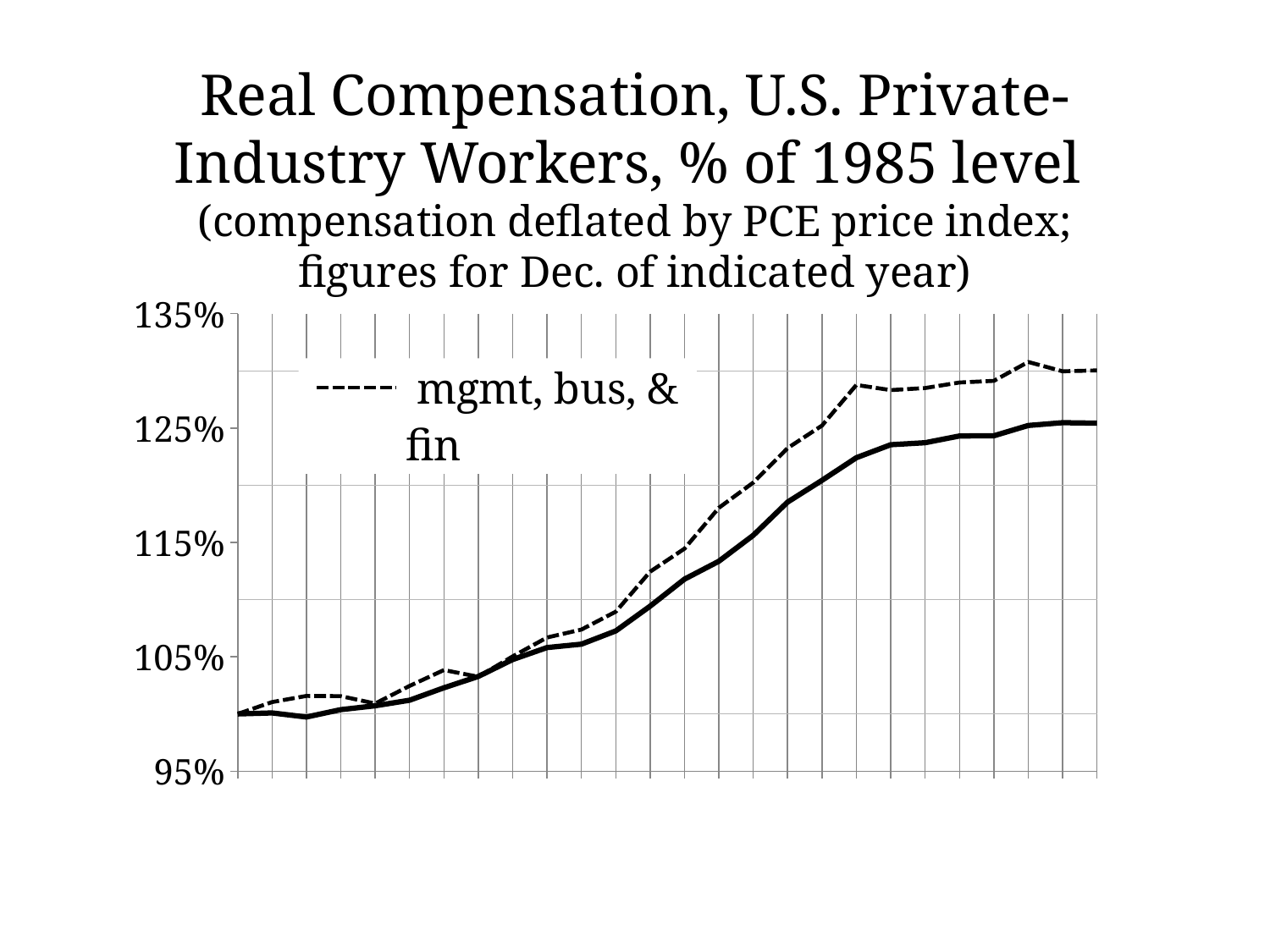
What is the lowest value shown on the vertical axis? 95% What is the title of the chart? Real Compensation, U.S. Private-Industry Workers, % of 1985 level What kind of chart is shown on the slide? line chart Do the values of the solid line generally rise or fall from left to right? rise Do the values of the dashed 'mgmt, bus, & fin' line generally rise or fall from left to right? rise Is the final value of the dashed 'mgmt, bus, & fin' line greater or less than 125%? greater What series name does the legend list for the dashed line? mgmt, bus, & fin Is the starting value of the solid line at the left of the chart greater or less than 105%? less At the right end of the chart, which line is higher: the dashed 'mgmt, bus, & fin' line or the solid line? the dashed 'mgmt, bus, & fin' line Is the highest value reached by the dashed 'mgmt, bus, & fin' line greater or less than 135%? less How many series entries does the legend list? 1